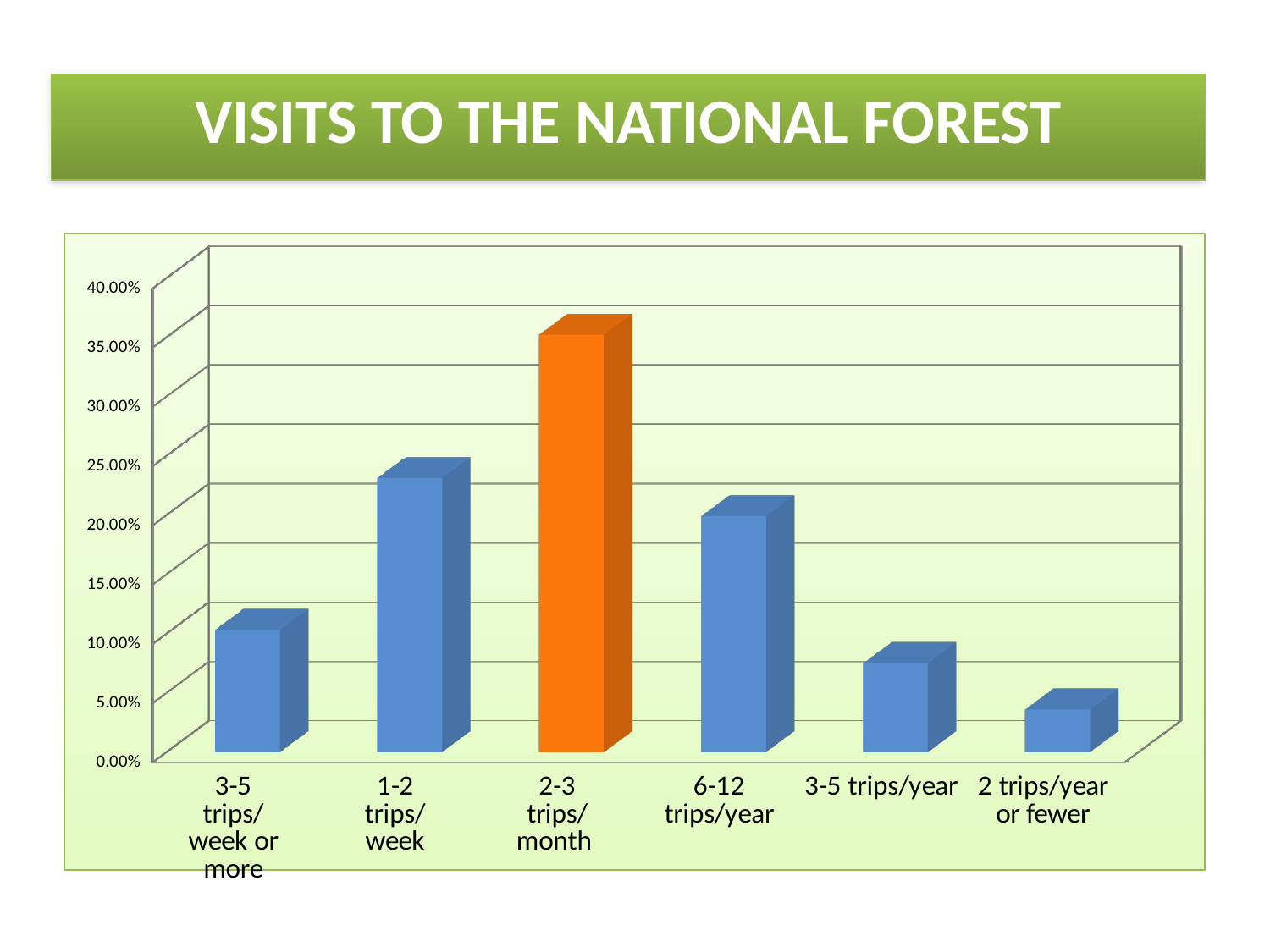
What kind of chart is shown on the slide? bar chart Is the value for 2 trips/year or fewer greater or less than 5.00%? less Which is larger, the value for 1-2 trips/week or the value for 6-12 trips/year? 1-2 trips/week Is the value for 2-3 trips/month greater or less than 30.00%? greater Which category has the lowest value? 2 trips/year or fewer Is the value for 1-2 trips/week greater or less than 20.00%? greater How many categories are shown on the x axis? 6 Which category has the highest value? 2-3 trips/month Which is larger, the value for 3-5 trips/week or more or the value for 3-5 trips/year? 3-5 trips/week or more What is the title of the slide containing the chart? VISITS TO THE NATIONAL FOREST